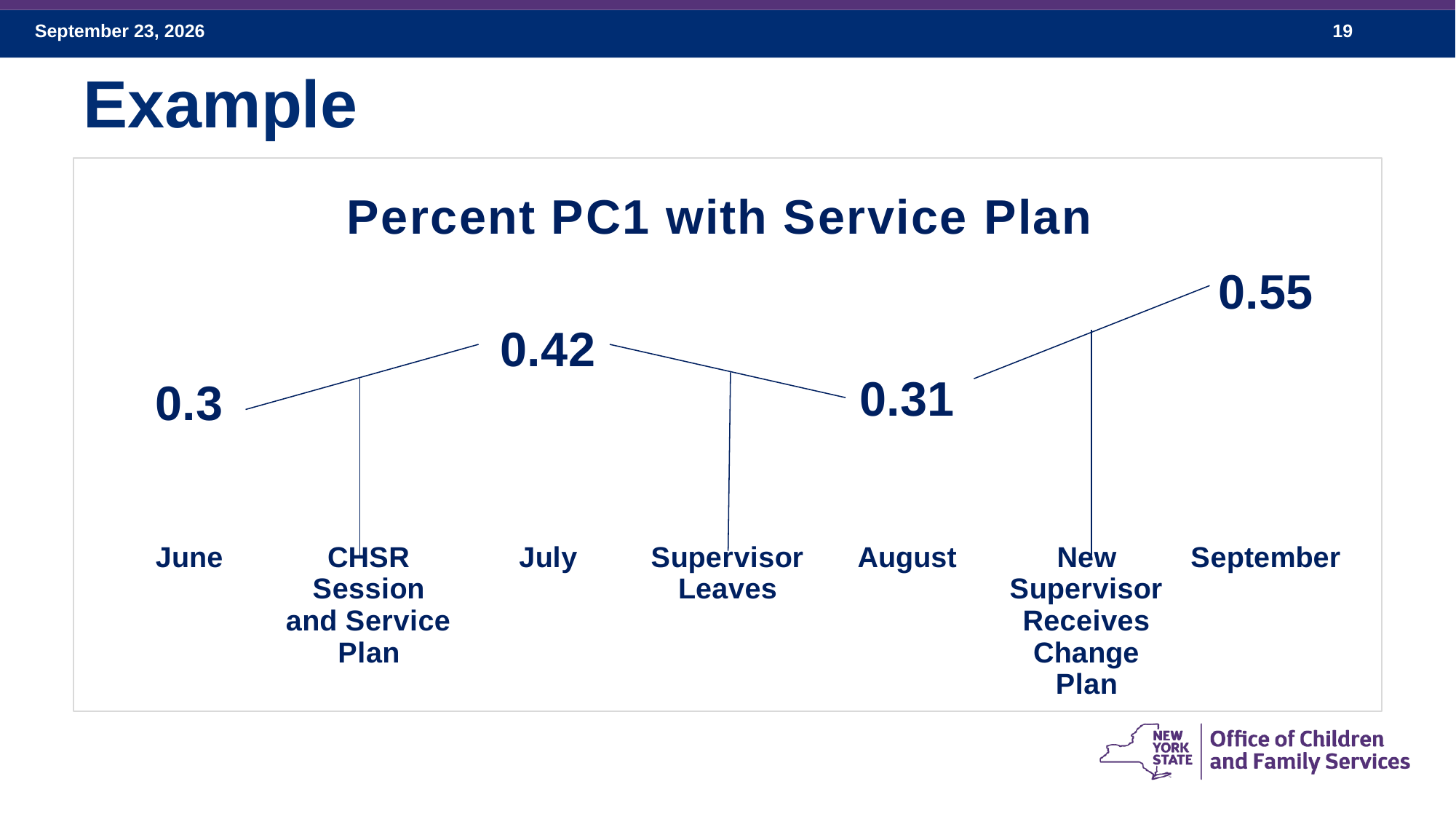
What kind of chart is the Percent PC1 with Service Plan chart? Line chart Which month has the highest value in the Percent PC1 with Service Plan chart? September How many months have values plotted in the Percent PC1 with Service Plan chart? 4 What is the value for August in the Percent PC1 with Service Plan chart? 0.31 What is the difference between the July and June values in the Percent PC1 with Service Plan chart? 0.12 What is the value for June in the Percent PC1 with Service Plan chart? 0.3 What is the value for July in the Percent PC1 with Service Plan chart? 0.42 Which month has the lowest value in the Percent PC1 with Service Plan chart? June What is the value for September in the Percent PC1 with Service Plan chart? 0.55 What is the difference between the September and August values in the Percent PC1 with Service Plan chart? 0.24 What event is marked on the x axis between August and September in the Percent PC1 with Service Plan chart? New Supervisor Receives Change Plan Which is larger in the Percent PC1 with Service Plan chart, the value for July or the value for August? July